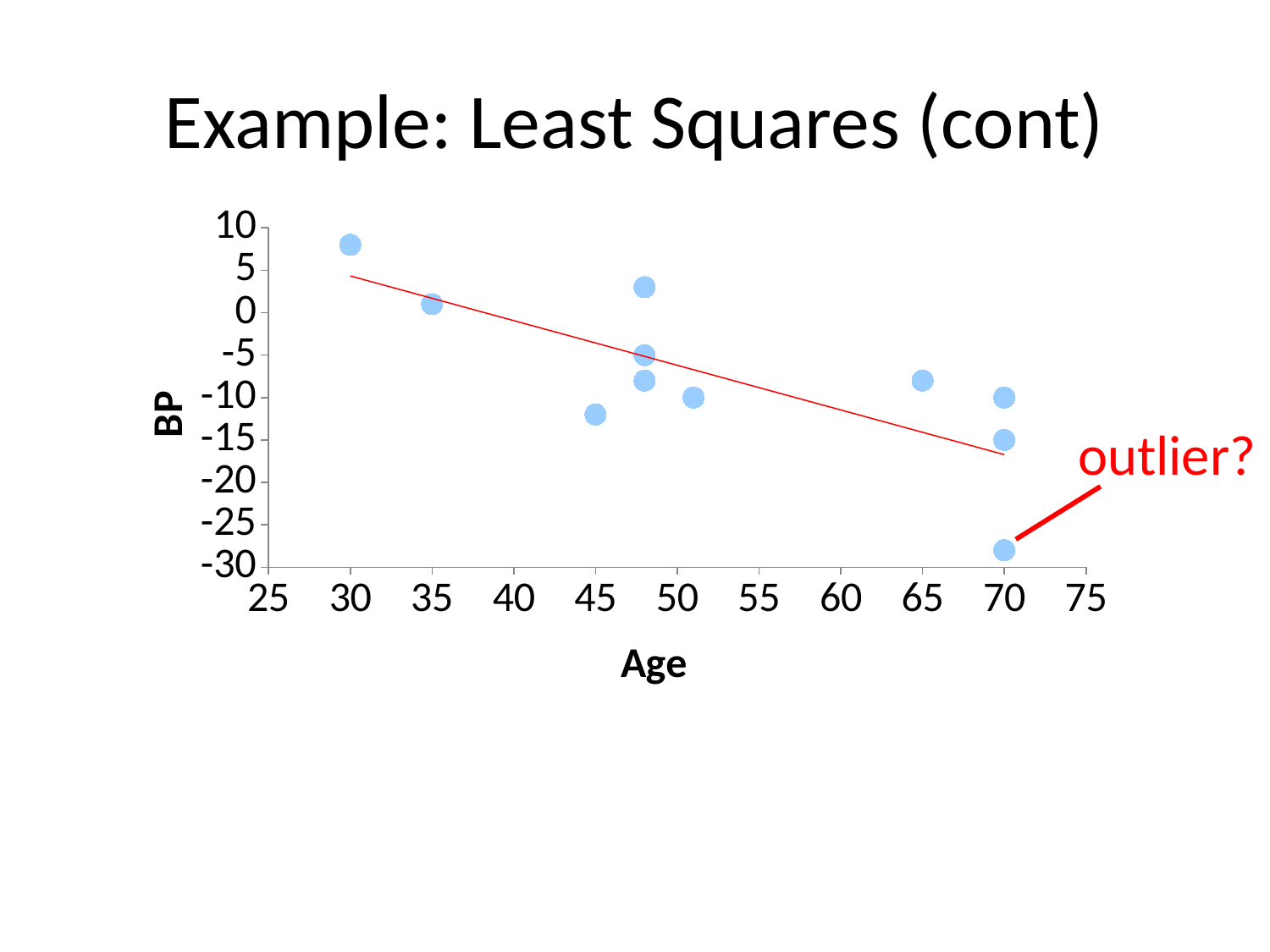
How many data points are plotted on the chart? 11 Is the BP value for Age 65 greater or less than -10? greater Is the BP value for Age 30 greater or less than 5? greater At which Age is the lowest BP value plotted? 70 Is the BP value for Age 45 greater or less than -10? less What is the label of the x axis? Age At which Age is the highest BP value plotted? 30 What kind of chart is shown on the slide? scatter plot Do the BP values generally rise or fall as Age increases along the x axis? fall What is the label of the y axis? BP Which has the larger BP value, the point at Age 35 or the point at Age 45? Age 35